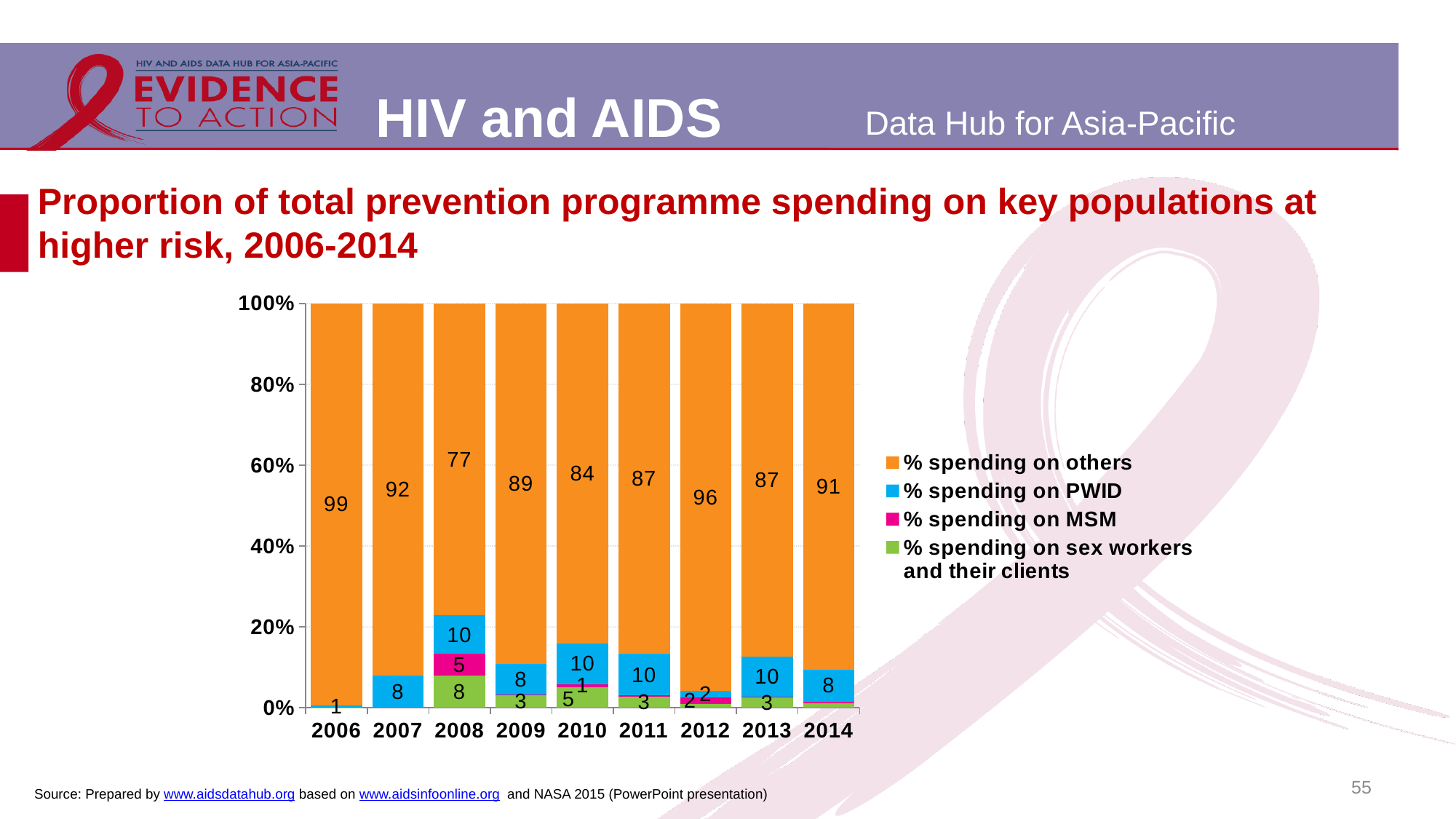
What kind of chart is shown on the slide? Stacked bar chart How many series does the legend list? 4 What colour represents % spending on others in the chart? Orange In which year is the % spending on others the lowest? 2008 What is the value labelled for % spending on others in 2008? 77 How many years are shown on the x axis? 9 In which year is the % spending on others the highest? 2006 What is the value labelled for % spending on sex workers and their clients in 2010? 5 What is the value labelled for % spending on PWID in 2007? 8 What is the value labelled for % spending on MSM in 2008? 5 Which year has a larger % spending on others, 2009 or 2011? 2009 What is the difference between the % spending on others in 2014 and in 2013? 4